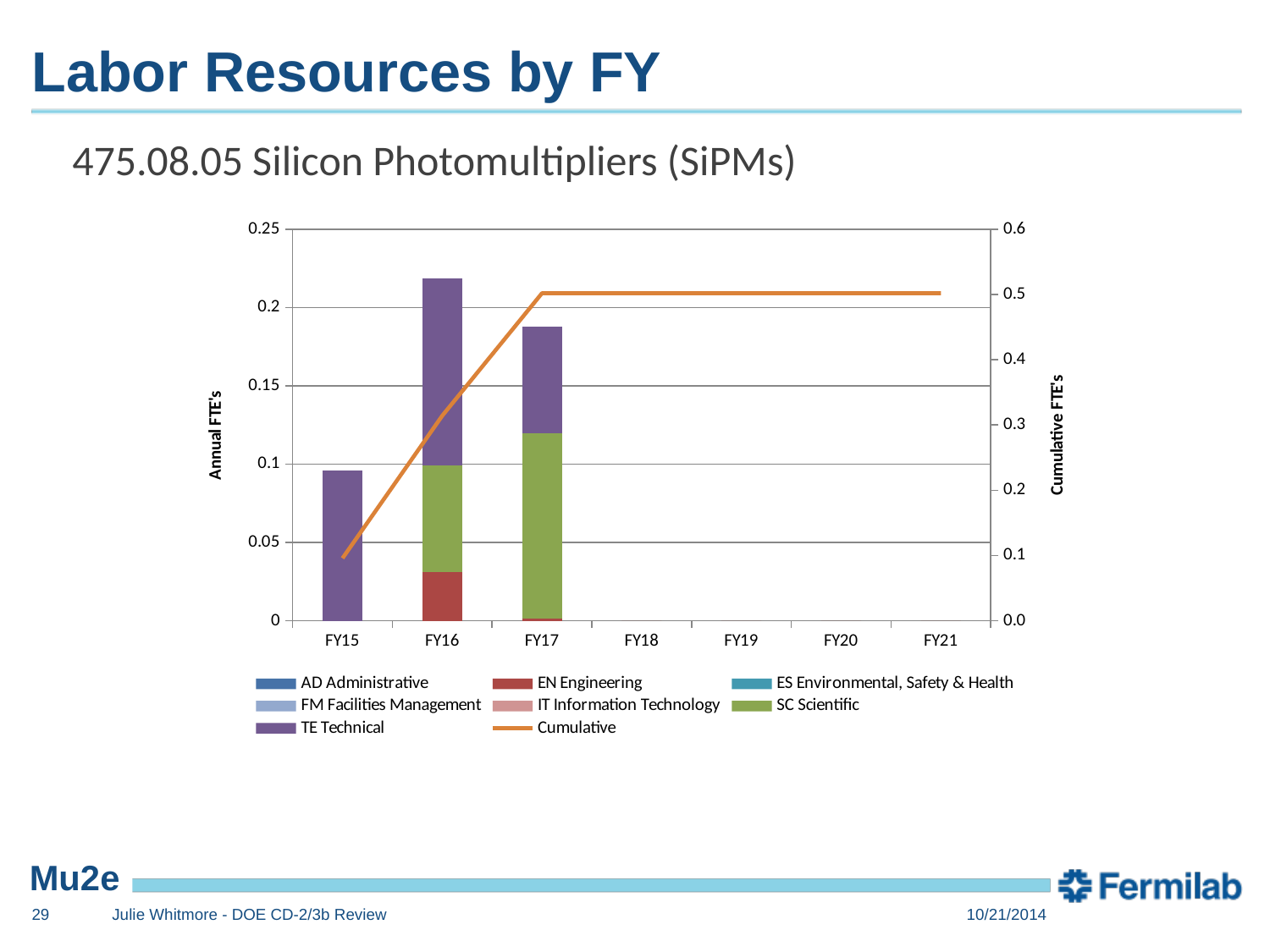
How many series does the legend list? 8 Is the total annual FTE's bar for FY16 greater or less than 0.2? greater Is the total annual FTE's bar for FY17 greater or less than 0.15? greater What kind of chart is shown on the slide? Stacked bar chart with a line How many fiscal years are shown on the x axis? 7 What is the subtitle above the chart? 475.08.05 Silicon Photomultipliers (SiPMs) How does the Cumulative line behave from FY17 through FY21? It stays flat Which series is the only one making up the FY15 bar? TE Technical Which has the larger total annual FTE's bar, FY16 or FY17? FY16 Which fiscal year has the tallest stacked bar? FY16 Which fiscal years have no bars plotted? FY18, FY19, FY20, FY21 Is the Cumulative line value at FY21 greater or less than 0.4 on the right axis? greater